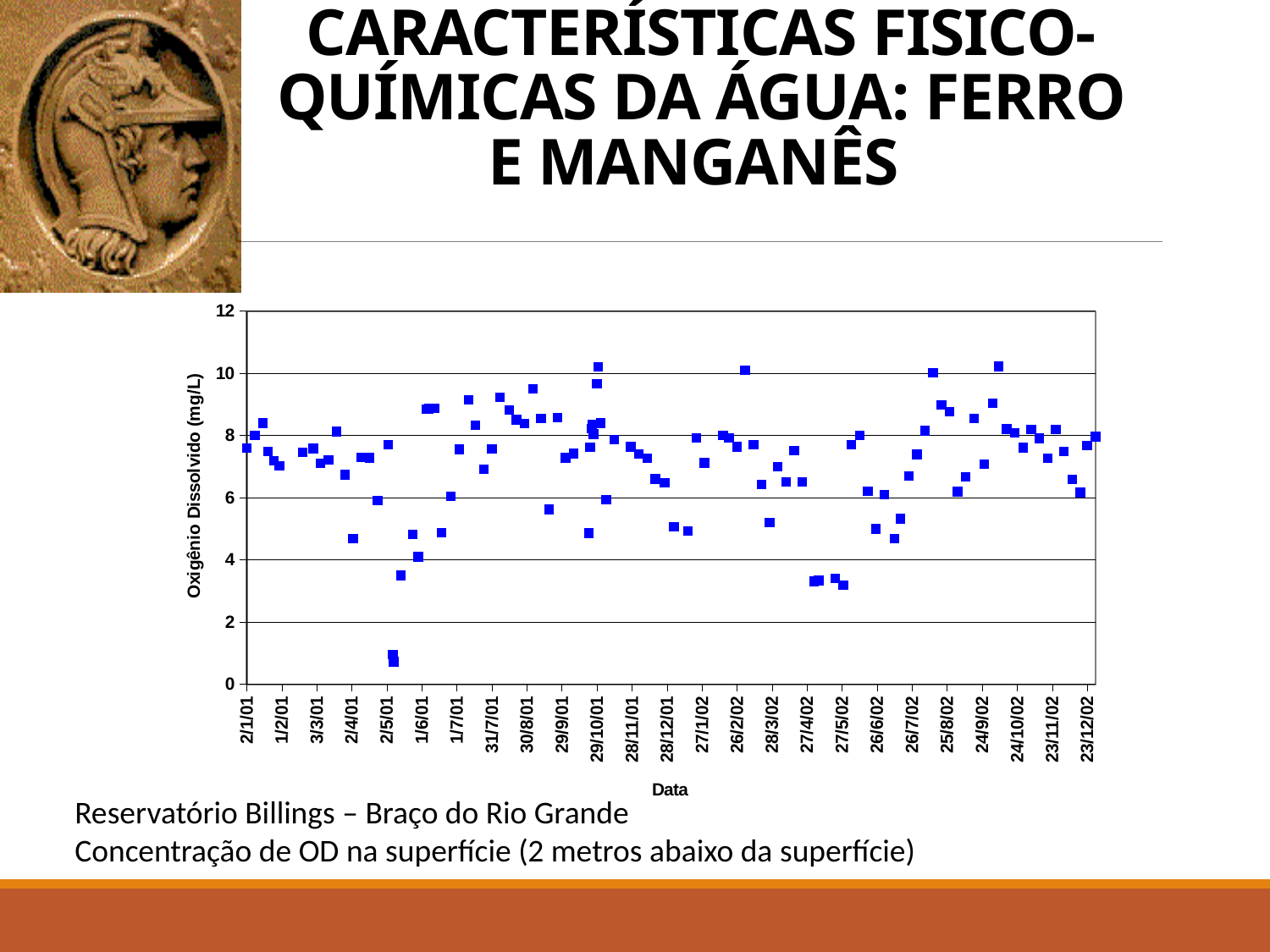
Is the dissolved oxygen value at 30/8/01 greater or less than 8? greater Around which date does the chart show its lowest dissolved oxygen value? 2/5/01 What is the label of the y axis of the chart? Oxigênio Dissolvido (mg/L) How many date labels are shown along the x axis of the chart? 25 What is the label of the x axis of the chart? Data Which has the higher dissolved oxygen value, the point at 30/8/01 or the point at 27/4/02? 30/8/01 What kind of chart is shown on the slide? scatter chart Is the dissolved oxygen value at 2/1/01 greater or less than 8? less Is the dissolved oxygen value at 27/5/02 greater or less than 4? less